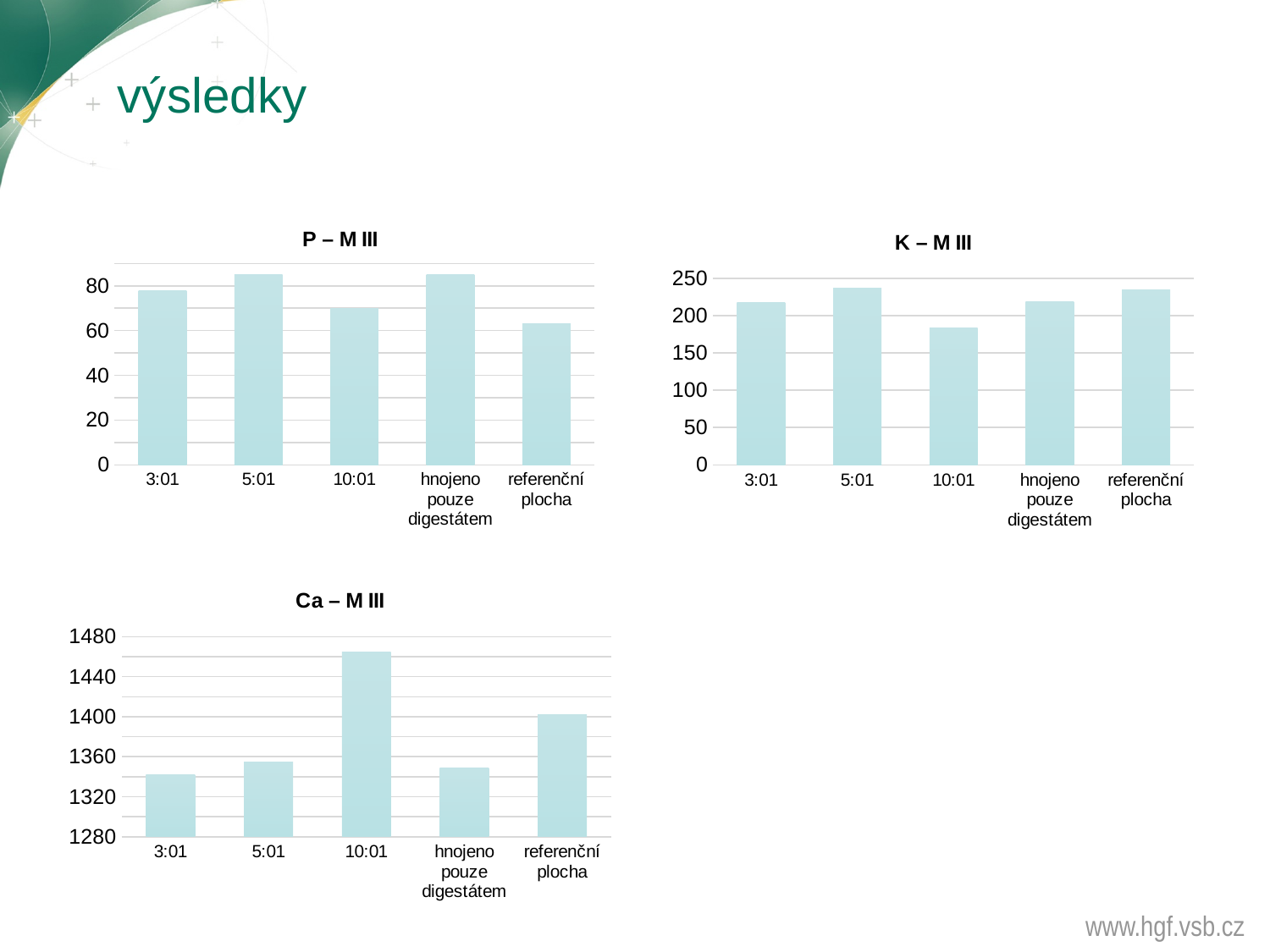
In the chart titled "K – M III", which category has the lowest value? 10:01 In the chart titled "P – M III", which category has the lowest value? referenční plocha What kind of chart is the chart titled "K – M III"? bar chart In the chart titled "Ca – M III", is the value for 10:01 greater or less than 1440? greater In the chart titled "Ca – M III", which category has the highest value? 10:01 How many charts are shown on the slide? 3 In the chart titled "K – M III", is the value for 10:01 greater or less than 200? less In the chart titled "P – M III", is the value for 10:01 greater or less than 80? less In the chart titled "Ca – M III", which is larger, the value for 10:01 or the value for referenční plocha? 10:01 In the chart titled "Ca – M III", how many categories are shown on the x axis? 5